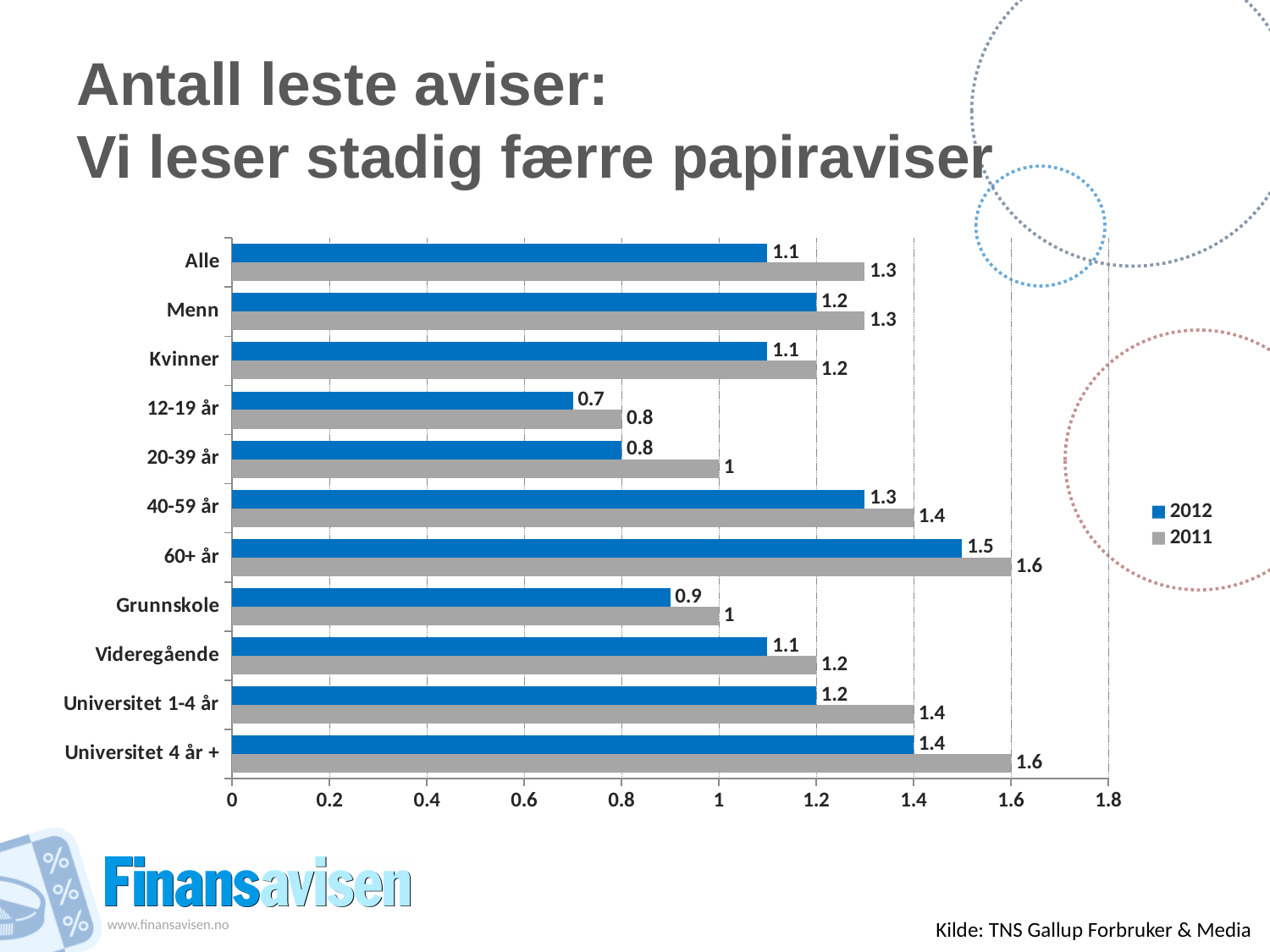
How many categories are shown on the y axis? 11 Which category has the highest 2012 value? 60+ år What kind of chart is shown on the slide? bar chart What is the 2012 value for 12-19 år? 0.7 What is the 2011 value for Universitet 1-4 år? 1.4 What is the 2012 value for 60+ år? 1.5 What is the difference between the 2011 and 2012 values for Universitet 1-4 år? 0.2 Which category has the lowest 2012 value? 12-19 år How many series does the legend list? 2 Which series is shown in blue? 2012 What is the 2011 value for Alle? 1.3 Which is larger for Grunnskole, the 2012 value or the 2011 value? 2011